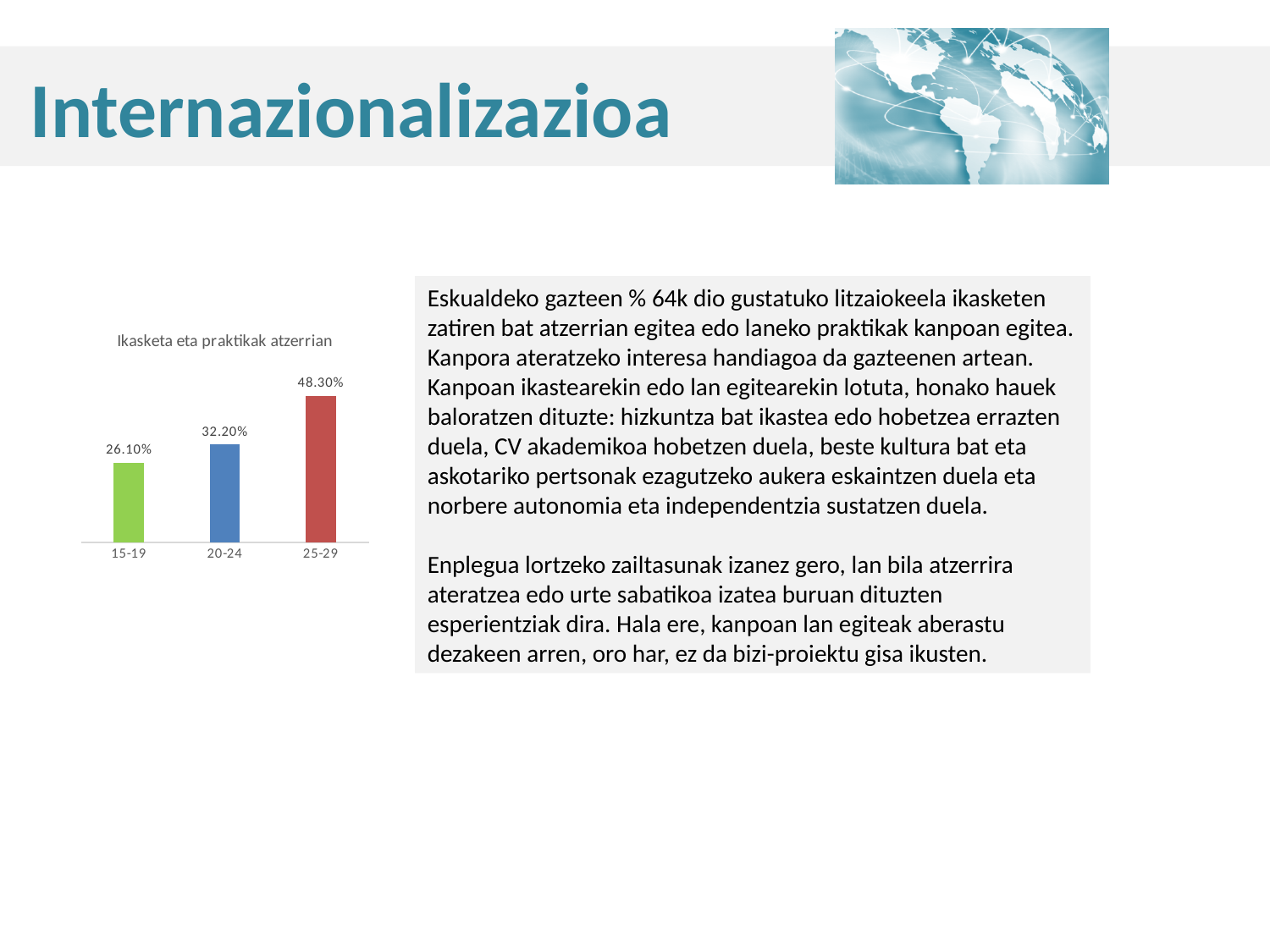
Which is larger, the value for 20-24 or the value for 25-29? 25-29 What kind of chart is shown on the slide? bar chart What is the value for the 15-19 age group? 26.10% What is the title of the chart? Ikasketa eta praktikak atzerrian What is the difference between the values for 25-29 and 15-19? 22.20% What is the value for the 20-24 age group? 32.20% How many age groups are shown in the chart? 3 Do the values rise or fall as the age groups increase along the x axis? rise Which age group has the highest value? 25-29 What is the value for the 25-29 age group? 48.30% What is the difference between the values for 20-24 and 15-19? 6.10% Which age group has the lowest value? 15-19